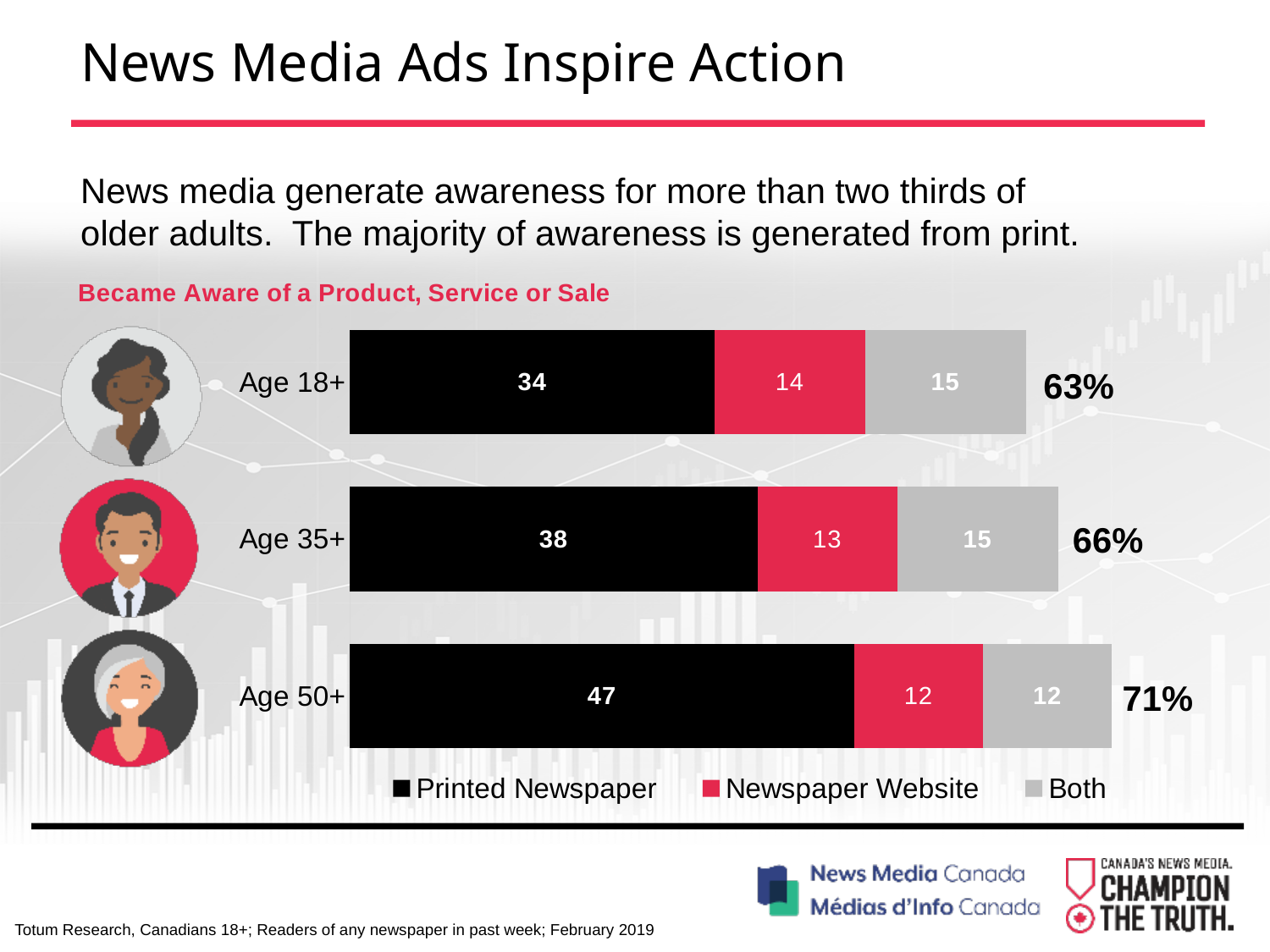
What is the difference between the Printed Newspaper values for Age 50+ and Age 18+? 13 What is the total shown for the Age 18+ bar? 63% What is the Newspaper Website value for Age 18+? 14 How many series does the legend list? 3 What is the total shown for the Age 50+ bar? 71% What is the Both value for Age 35+? 15 What is the Printed Newspaper value for Age 50+? 47 What kind of chart is shown on the slide? Stacked bar chart Which age group has the highest Printed Newspaper value? Age 50+ Which is larger, the Printed Newspaper value for Age 35+ or for Age 18+? Age 35+ How many age groups are shown in the chart? 3 Which age group has the lowest Newspaper Website value? Age 50+